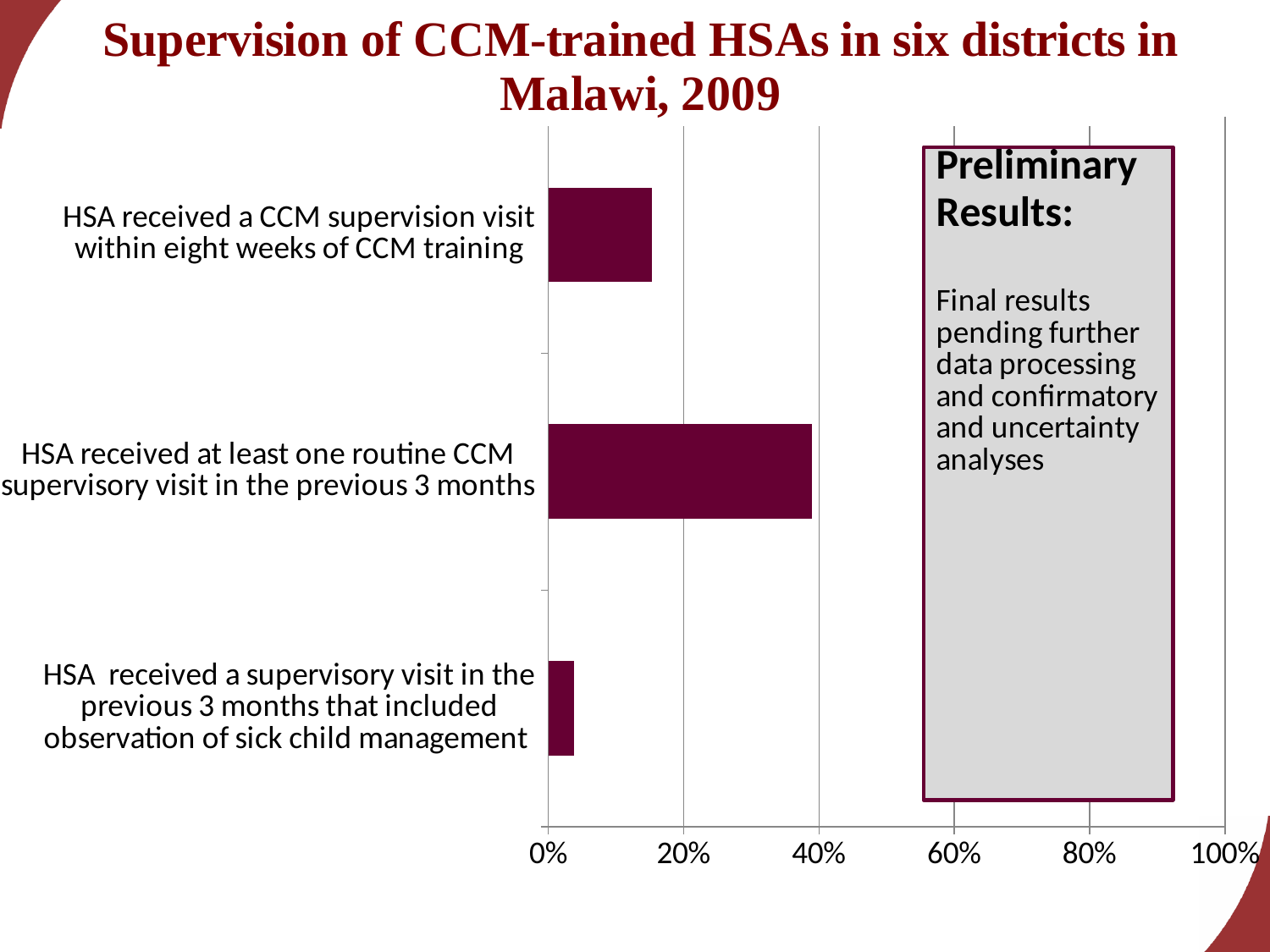
Which is larger: the value for 'HSA received a CCM supervision visit within eight weeks of CCM training' or the value for 'HSA received a supervisory visit in the previous 3 months that included observation of sick child management'? HSA received a CCM supervision visit within eight weeks of CCM training Is the value for 'HSA received at least one routine CCM supervisory visit in the previous 3 months' greater or less than 20%? greater What is the maximum value shown on the horizontal axis? 100% What is the title of the chart? Supervision of CCM-trained HSAs in six districts in Malawi, 2009 Is the value for 'HSA received a supervisory visit in the previous 3 months that included observation of sick child management' greater or less than 20%? less Is the value for 'HSA received at least one routine CCM supervisory visit in the previous 3 months' greater or less than 60%? less Which category has the lowest value? HSA received a supervisory visit in the previous 3 months that included observation of sick child management How many categories are plotted in the chart? 3 Which category has the highest value? HSA received at least one routine CCM supervisory visit in the previous 3 months What kind of chart is shown on the slide? bar chart